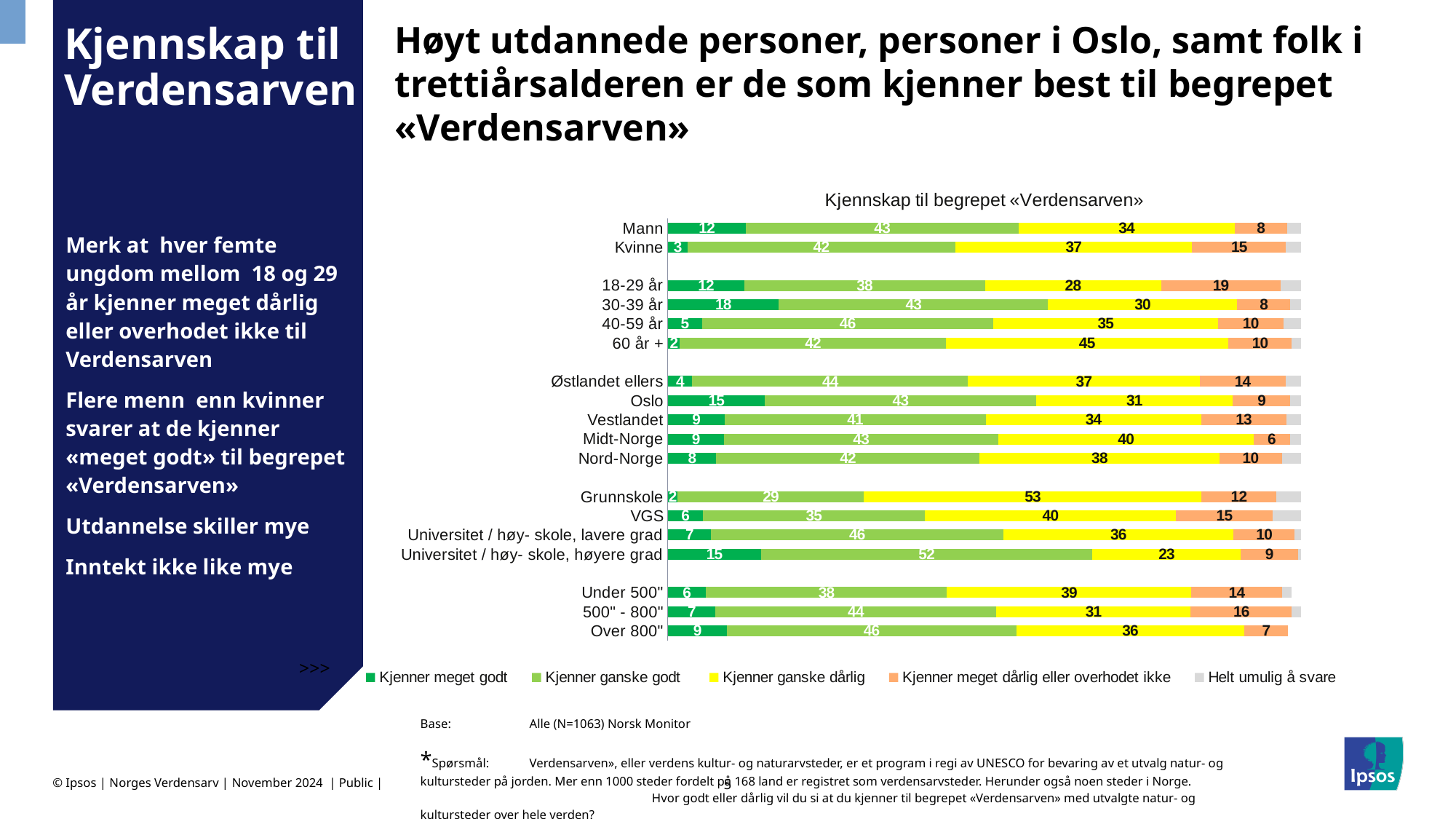
What is the value of "Kjenner ganske dårlig" for Grunnskole? 53 Which has a larger "Kjenner meget dårlig eller overhodet ikke" value, Oslo or Vestlandet? Vestlandet What is the title of the chart? Kjennskap til begrepet «Verdensarven» How many series does the legend list? 5 What kind of chart is shown on the slide? Stacked bar chart What is the value of "Kjenner ganske dårlig" for 60 år +? 45 Which category has the highest value for "Kjenner ganske godt"? Universitet / høy- skole, høyere grad What is the value of "Kjenner meget dårlig eller overhodet ikke" for 18-29 år? 19 What is the difference between the "Kjenner meget godt" values for Mann and Kvinne? 9 How many categories are plotted on the chart? 18 Which category has the lowest value for "Kjenner ganske godt"? Grunnskole What is the value of "Kjenner meget godt" for 30-39 år? 18